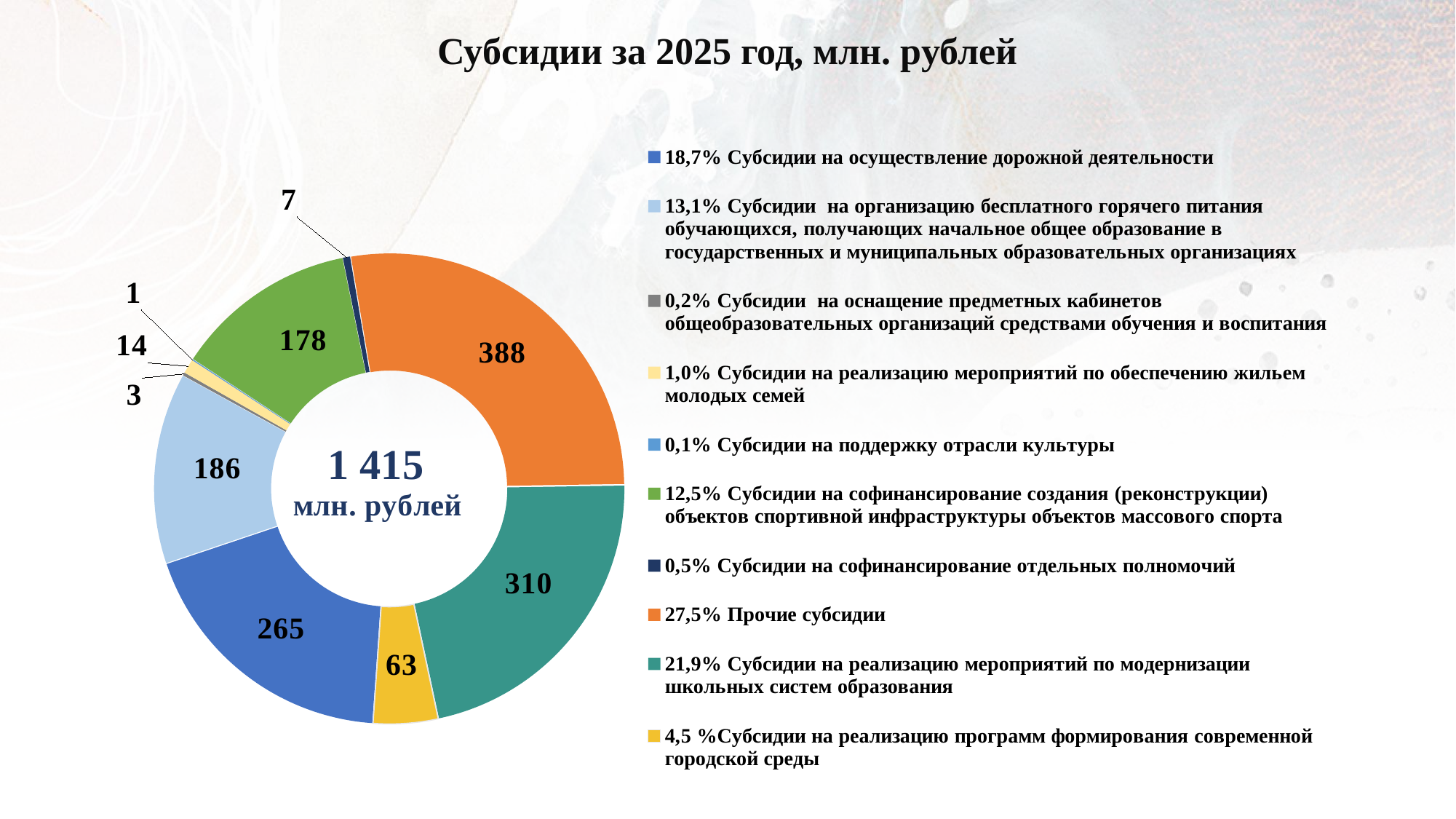
What total is shown in the centre of the chart? 1 415 млн. рублей What is the value for "Субсидии на реализацию программ формирования современной городской среды"? 63 What is the value for "Субсидии на реализацию мероприятий по модернизации школьных систем образования"? 310 How many categories does the chart show? 10 Which category has the largest value? Прочие субсидии What is the value for "Прочие субсидии"? 388 Which category has the smallest value? Субсидии на поддержку отрасли культуры What type of chart is shown on the slide? Pie (donut) chart What is the value for "Субсидии на осуществление дорожной деятельности"? 265 What is the difference between the values for "Прочие субсидии" and "Субсидии на осуществление дорожной деятельности"? 123 What share of the total does "Субсидии на реализацию мероприятий по модернизации школьных систем образования" represent? 21,9% Which is larger: the value for "Субсидии на организацию бесплатного горячего питания" or for "Субсидии на софинансирование создания (реконструкции) объектов спортивной инфраструктуры"? Субсидии на организацию бесплатного горячего питания